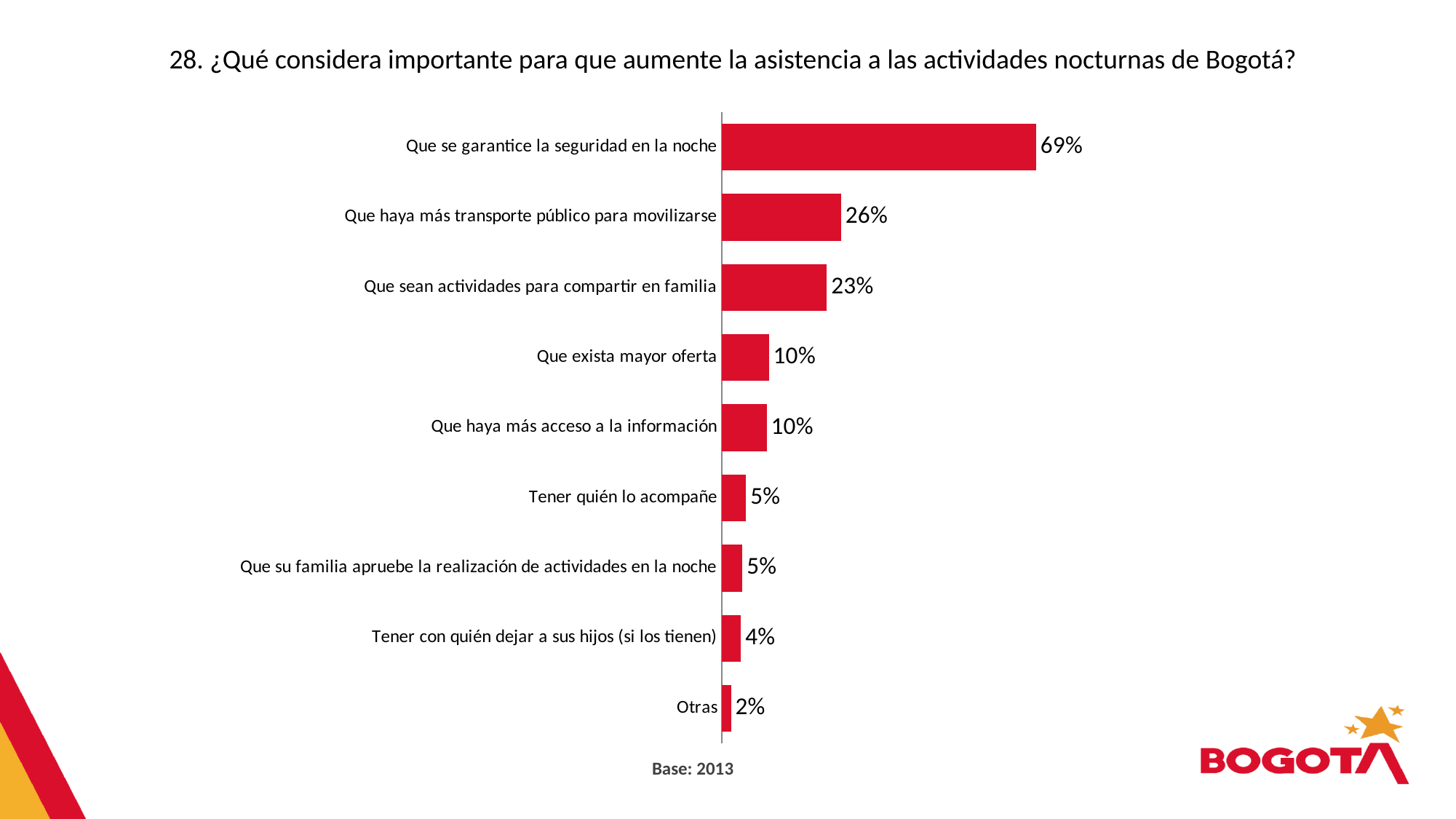
What colour are the bars in the chart? Red How many categories are shown in the chart? 9 What is the value for "Que sean actividades para compartir en familia"? 23% What is the difference between "Que se garantice la seguridad en la noche" and "Que haya más transporte público para movilizarse"? 43% What percentage of respondents chose "Que se garantice la seguridad en la noche"? 69% What is the value for "Que haya más transporte público para movilizarse"? 26% Which category has the highest value? Que se garantice la seguridad en la noche What is the base year noted below the chart? 2013 Which is larger: "Que haya más transporte público para movilizarse" or "Que sean actividades para compartir en familia"? Que haya más transporte público para movilizarse What kind of chart is shown on the slide? Bar chart What is the value for "Tener con quién dejar a sus hijos (si los tienen)"? 4% Which category has the lowest value? Otras